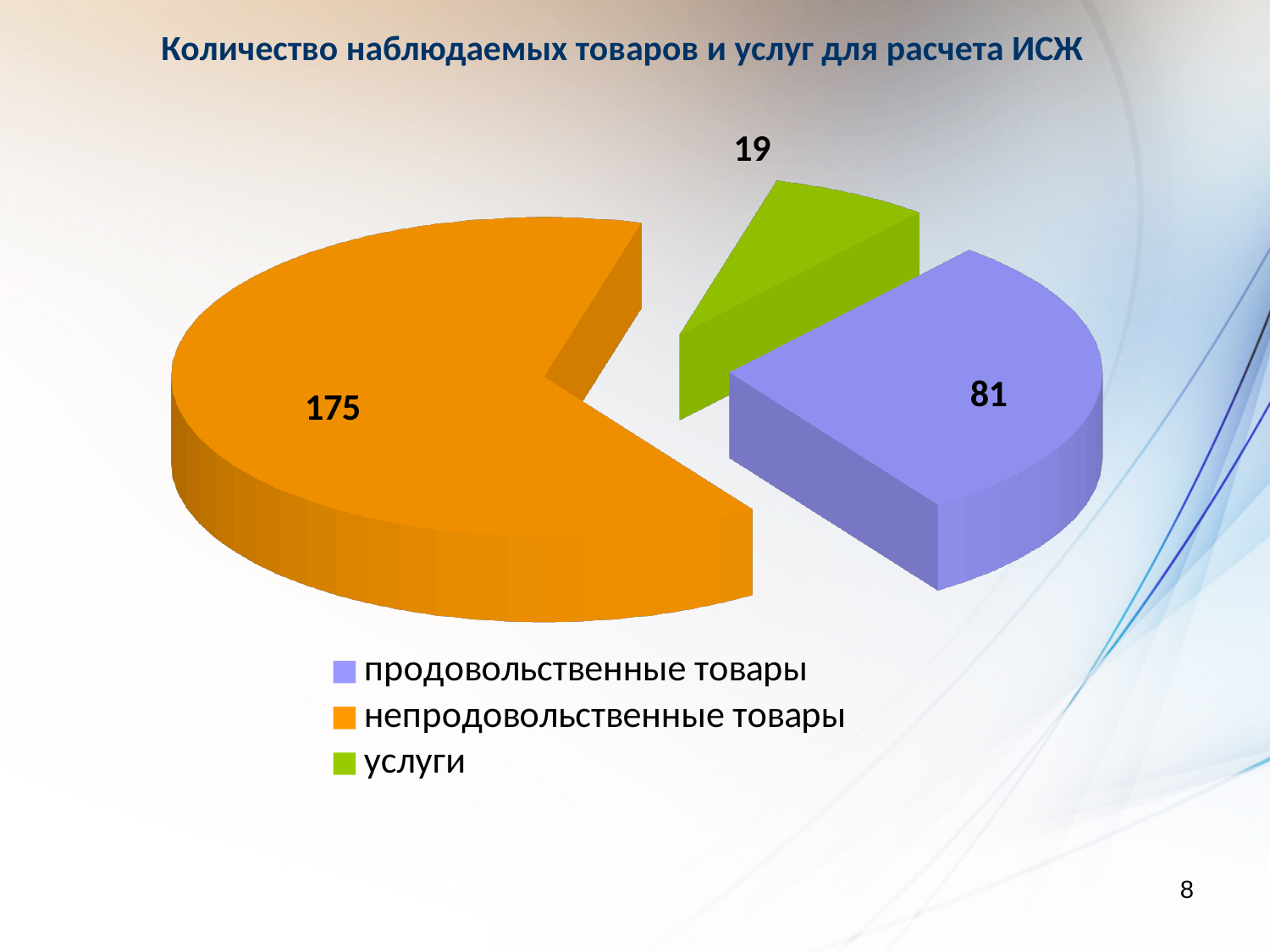
What is the difference between the values for непродовольственные товары and продовольственные товары? 94 What kind of chart is shown on the slide? pie chart What is the value for непродовольственные товары? 175 Which is larger, the value for продовольственные товары or the value for услуги? продовольственные товары What is the value for услуги? 19 Which category has the smallest slice of the pie? услуги What is the total of all the slices in the pie chart? 275 What is the difference between the values for продовольственные товары and услуги? 62 What colour is the slice for услуги? green How many categories are shown in the pie chart? 3 What is the value for продовольственные товары? 81 Which category has the largest slice of the pie? непродовольственные товары